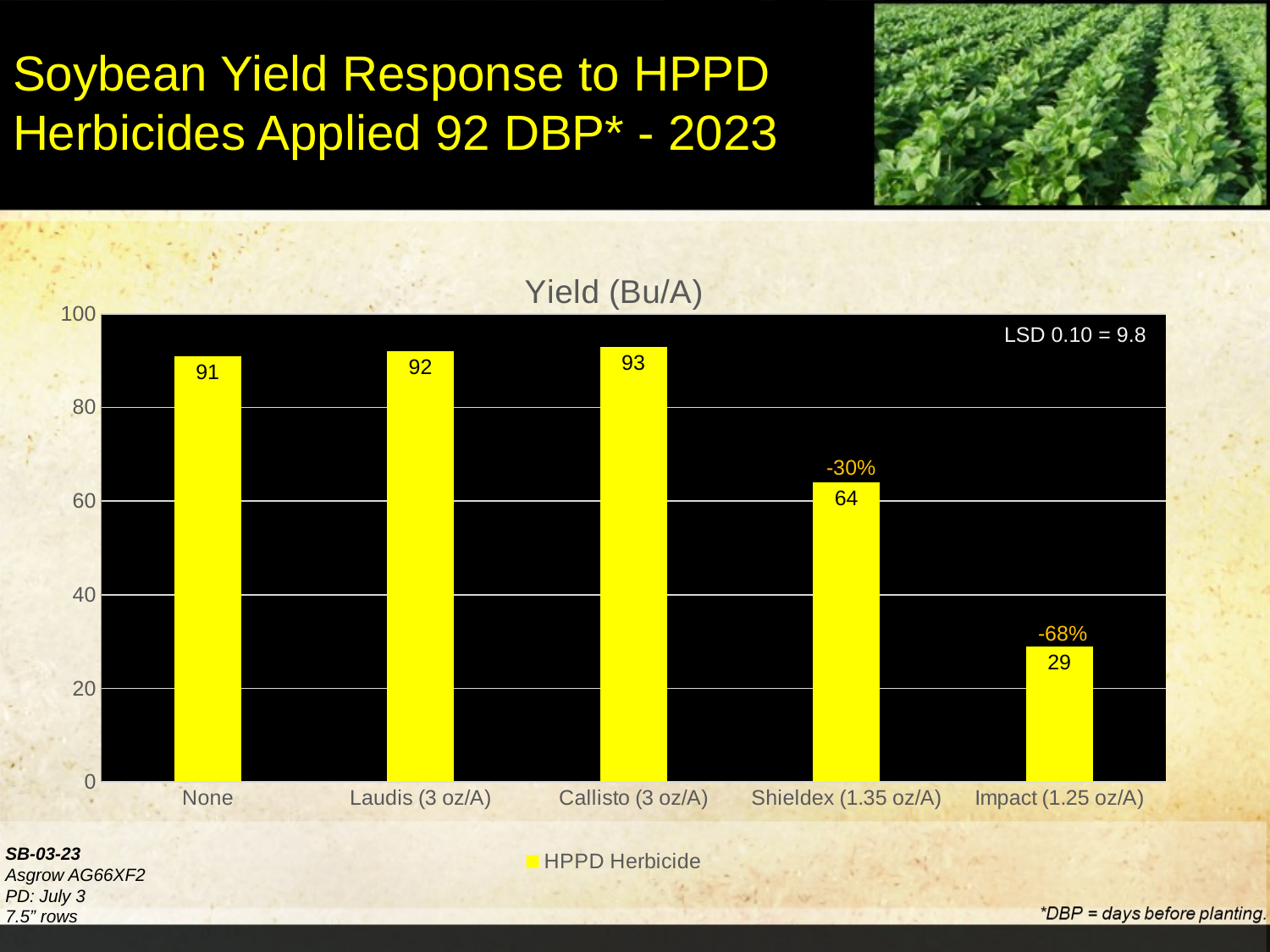
What is the yield value for Impact (1.25 oz/A)? 29 What kind of chart is shown? Bar chart What percentage change is labeled above the Shieldex (1.35 oz/A) bar? -30% How many treatments are shown on the x axis? 5 What is the yield value for the None treatment? 91 What is the difference in yield between None and Shieldex (1.35 oz/A)? 27 Which treatment has the highest yield? Callisto (3 oz/A) How many series does the legend list? 1 What is the yield value for Callisto (3 oz/A)? 93 Which treatment has the lowest yield? Impact (1.25 oz/A) Which has a higher yield, Shieldex (1.35 oz/A) or Impact (1.25 oz/A)? Shieldex (1.35 oz/A) What is the title of the chart? Yield (Bu/A)